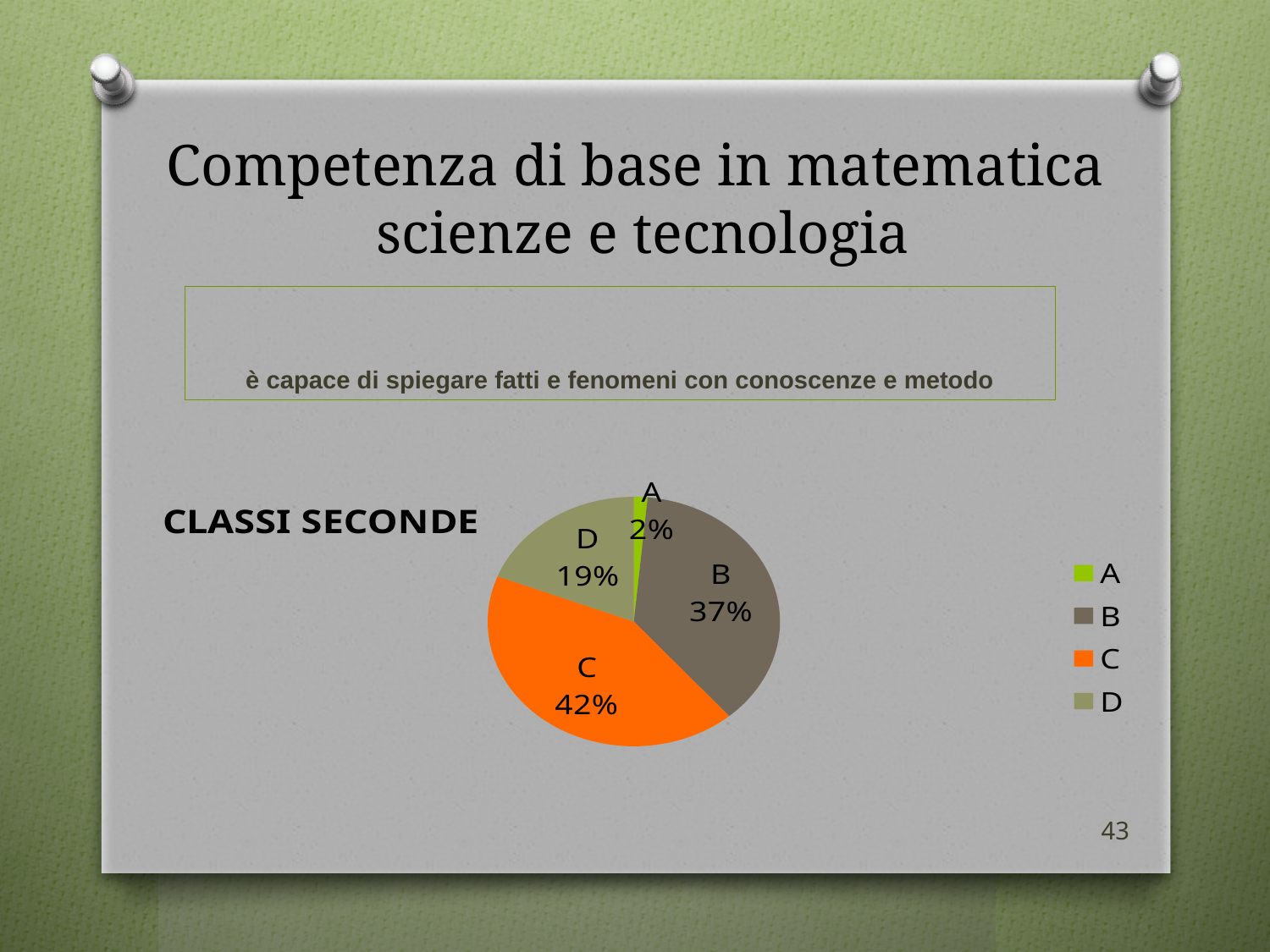
What is the share for category A in the pie chart? 2% What is the difference between the shares of C and B? 5% What is the share for category B in the pie chart? 37% What is the share for category D in the pie chart? 19% What is the difference between the shares of B and D? 18% Which is larger, the share for D or the share for A? D Which category has the largest slice of the pie chart? C How many categories does the pie chart show? 4 What is the share for category C in the pie chart? 42% What kind of chart is shown on the slide? pie chart Which category has the smallest slice of the pie chart? A What colour is the slice for category C in the pie chart? orange